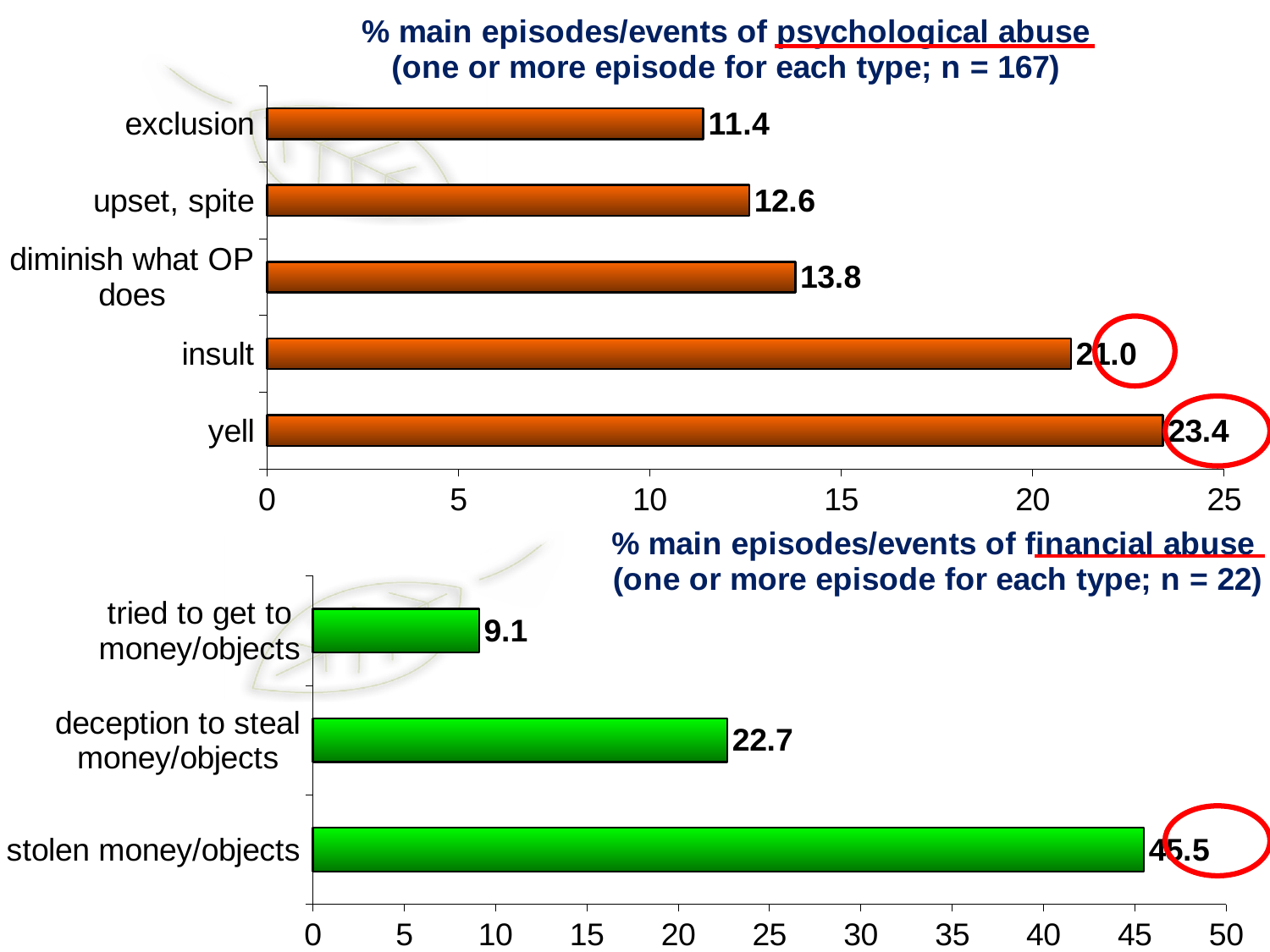
In the financial abuse chart, how many categories are shown? 3 In the psychological abuse chart, which category has the lowest value? exclusion In the financial abuse chart, what is the value for deception to steal money/objects? 22.7 In the financial abuse chart, which category has the highest value? stolen money/objects In the psychological abuse chart, what is the difference between the values for insult and diminish what OP does? 7.2 In the psychological abuse chart, what is the value for exclusion? 11.4 In the financial abuse chart, what is the difference between stolen money/objects and tried to get to money/objects? 36.4 What kind of chart is the financial abuse chart? bar chart In the psychological abuse chart, what is the value for yell? 23.4 In the psychological abuse chart, which category has the highest value? yell In the psychological abuse chart, is the value for insult greater or less than 20? greater In the psychological abuse chart, how many categories are shown? 5